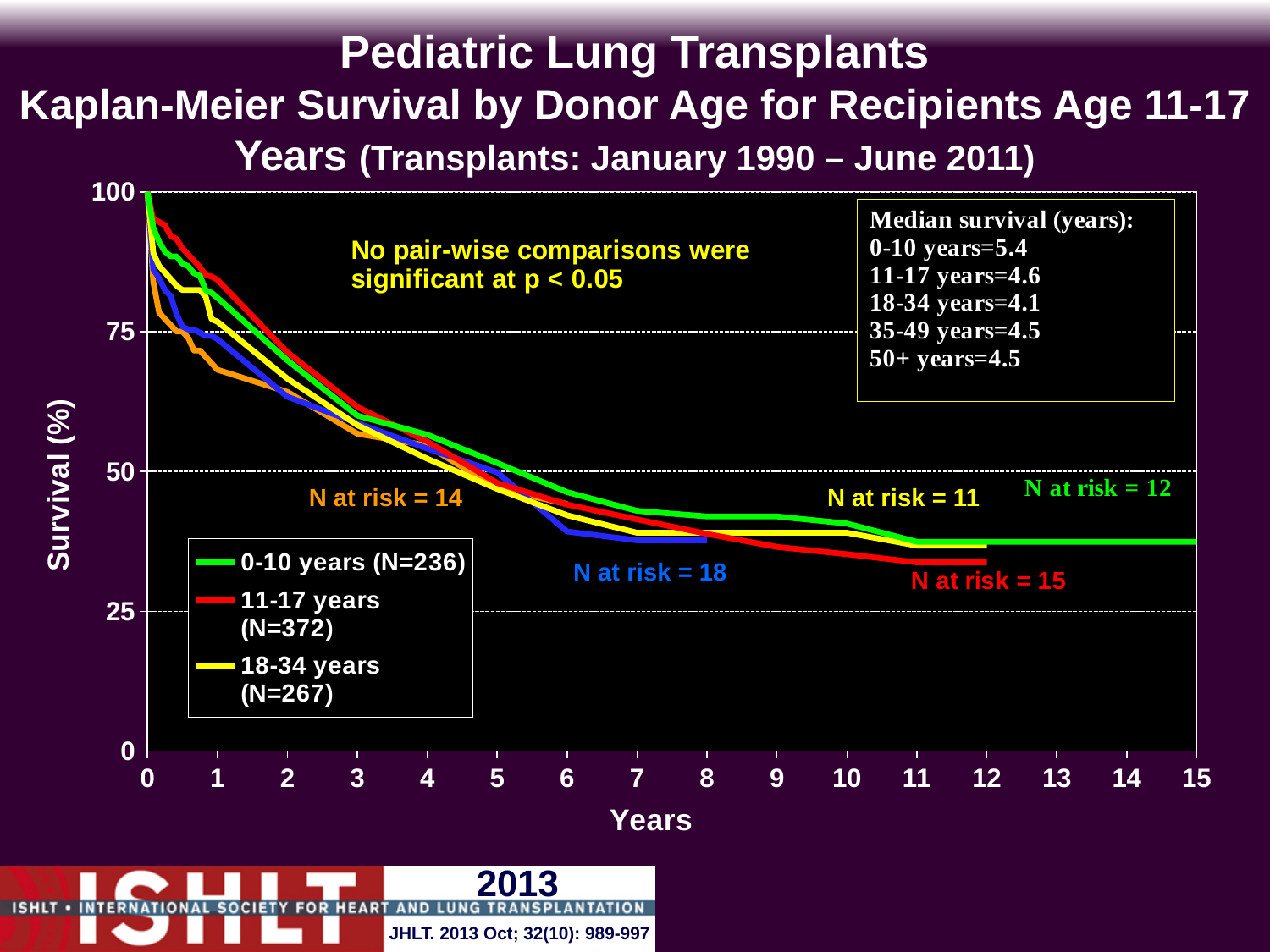
Which donor age group has the highest median survival? 0-10 years Is the survival value for the 11-17 years donor group at year 1 greater or less than 75? greater What is the N at risk shown for the 0-10 years donor group? 12 Do the survival curves rise or fall as the years increase? fall Is the survival value for the 0-10 years donor group at year 15 greater or less than 25? greater Is the survival value for the 11-17 years donor group at year 12 greater or less than 50? less What is the median survival in years for the 0-10 years donor group? 5.4 What kind of chart is shown on the slide? line chart What is the survival value for all groups at year 0? 100 How many series does the legend box list? 3 What is the N for the 11-17 years donor group in the legend? 372 At year 12, which curve is higher: the 0-10 years group or the 11-17 years group? 0-10 years